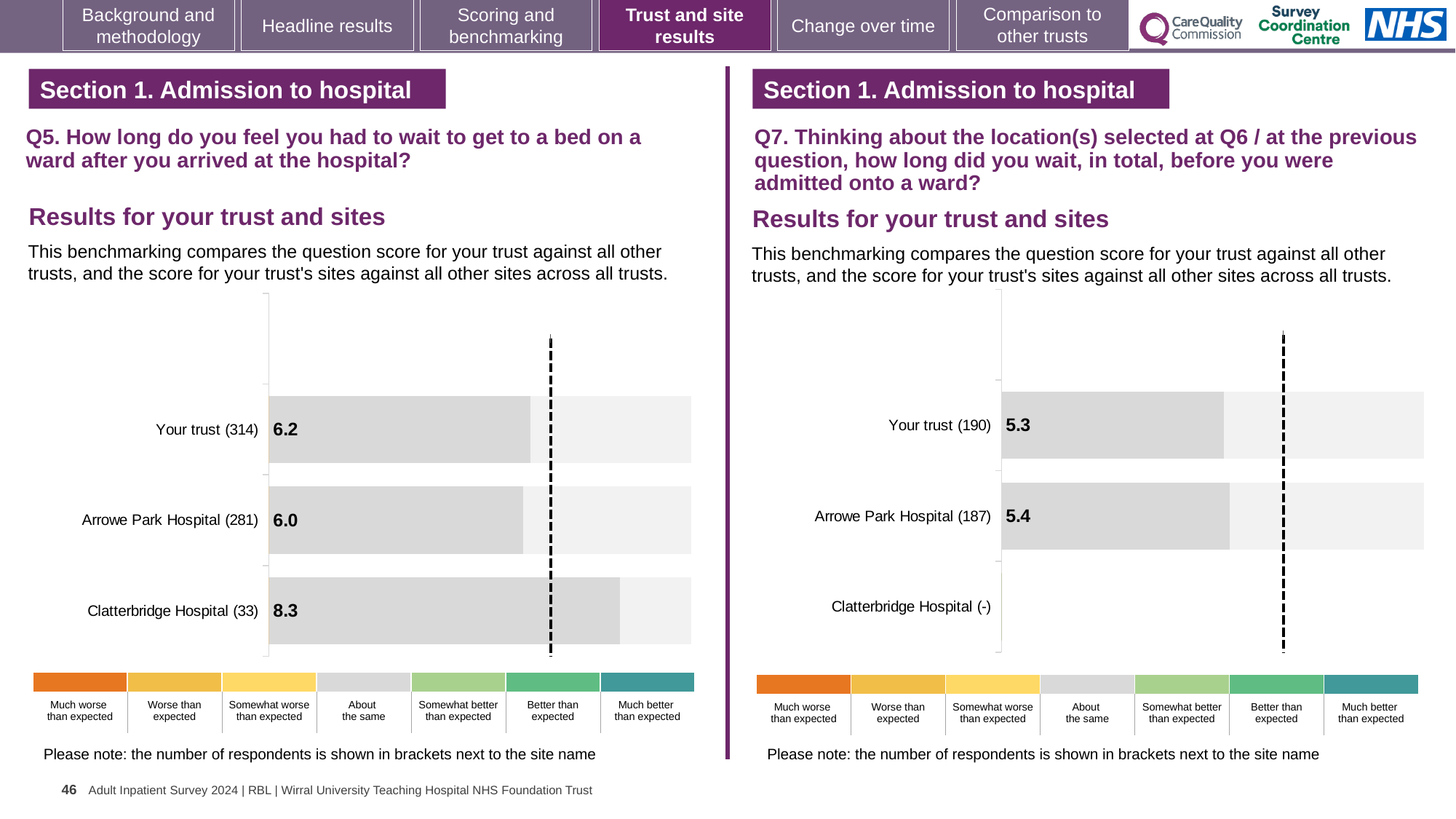
On the Q7 chart (right), which is larger, the score for Your trust or the score for Arrowe Park Hospital? Arrowe Park Hospital How many rows (trust and sites) are listed on the Q5 chart (left)? 3 On the Q5 chart (left), which site or trust has the lowest score? Arrowe Park Hospital On the Q5 chart (left), how many respondents are shown for Arrowe Park Hospital? 281 On the Q7 chart (right), what is the score for Your trust? 5.3 On the Q5 chart (left), what is the score for Your trust? 6.2 On the Q7 chart (right), what is the score for Arrowe Park Hospital? 5.4 On the Q5 chart (left), which site or trust has the highest score? Clatterbridge Hospital On the Q5 chart (left), what is the difference between the Clatterbridge Hospital score and the Your trust score? 2.1 On the Q7 chart (right), how many respondents are shown for Your trust? 190 What kind of chart is used on the Q5 chart (left)? Bar chart On the Q5 chart (left), what is the score for Clatterbridge Hospital? 8.3